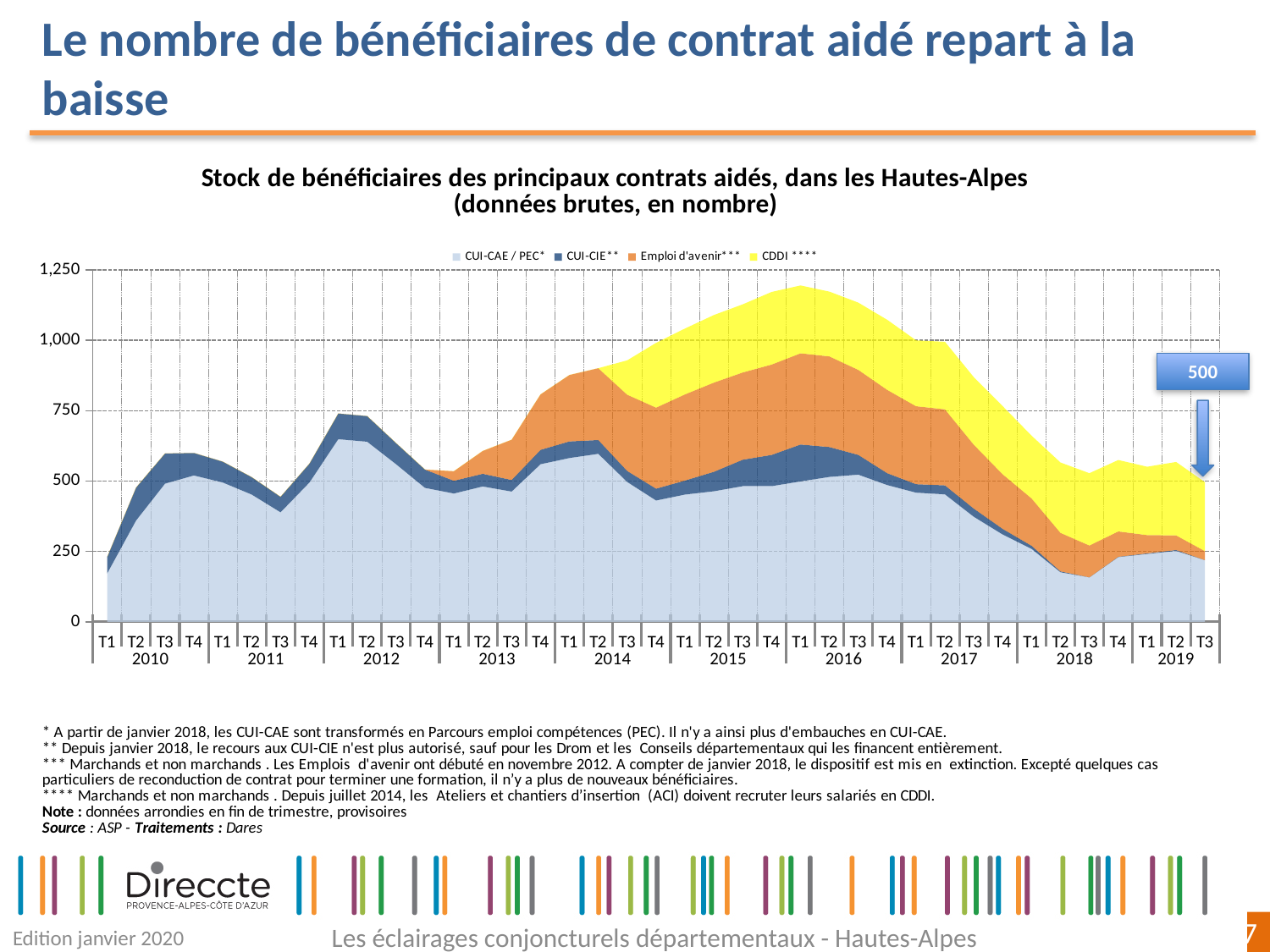
Is the total stock of beneficiaries in T1 2012 greater or less than 500? greater What total value is labelled for T3 2019? 500 Is the total stock of beneficiaries in T1 2014 greater or less than 750? greater Is the total stock of beneficiaries in T1 2016 greater or less than 1,000? greater How many quarters are plotted on the x axis? 39 How many series does the legend list? 4 What kind of chart is shown on the slide? Stacked area chart Which is larger, the total stock in T1 2016 or in T3 2019? T1 2016 Does the total stock of beneficiaries rise or fall between T1 2016 and T3 2019? Fall In which quarter does the total stock of beneficiaries reach its highest level? T1 2016 Which colour represents the CDDI series in the legend? Yellow